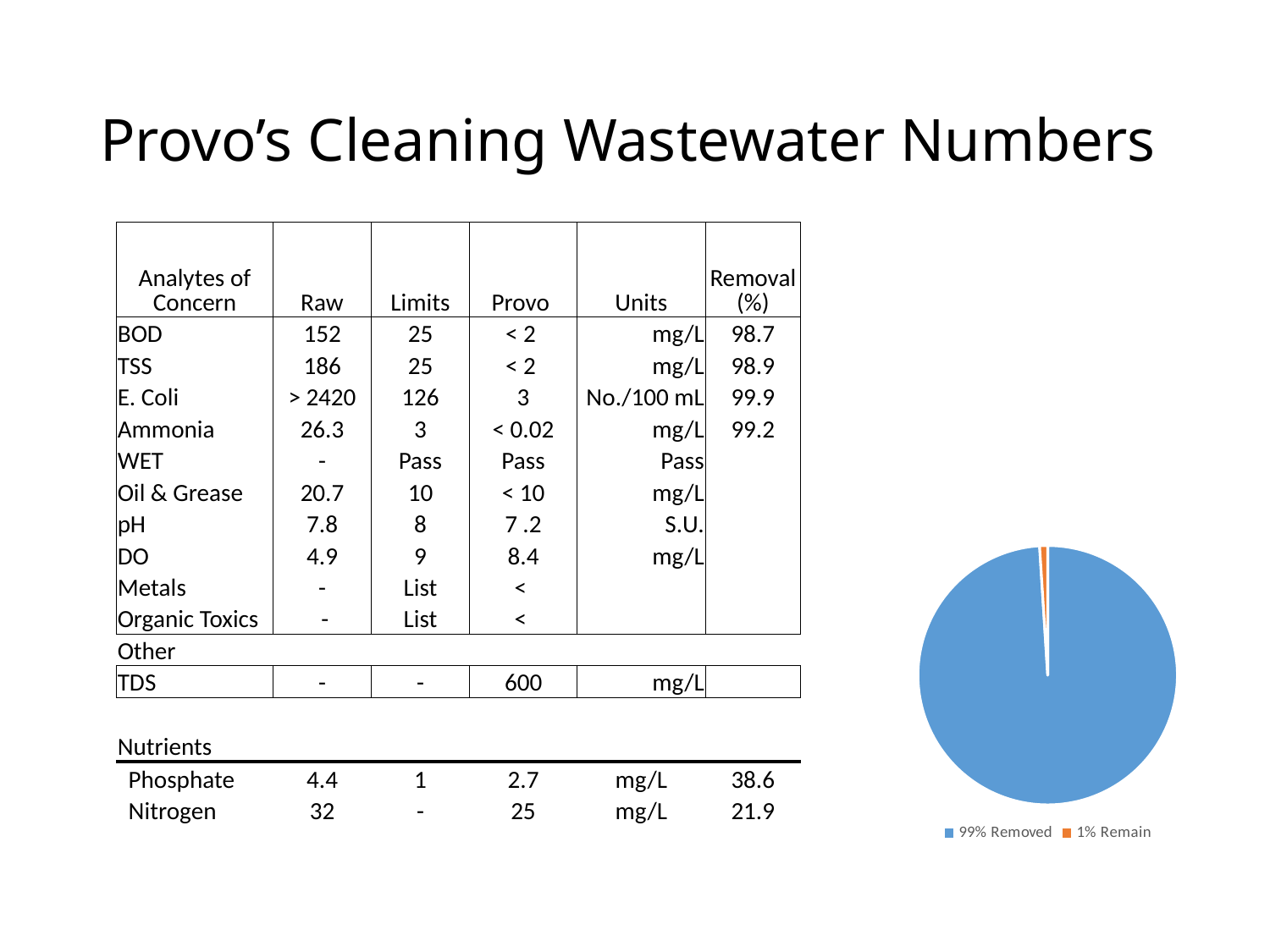
Which slice of the pie chart is the smallest? 1% Remain How many entries does the legend of the pie chart list? 2 Which slice of the pie chart is the largest? 99% Removed According to the legend of the pie chart, what share of the pie does the 'Removed' slice represent? 99% What kind of chart is shown on the right side of the slide? pie chart In the pie chart, which is larger: the '99% Removed' slice or the '1% Remain' slice? 99% Removed According to the legend of the pie chart, what share of the pie does the 'Remain' slice represent? 1% How many slices does the pie chart on the right have? 2 What colour is the '1% Remain' slice in the pie chart? orange What colour is the '99% Removed' slice in the pie chart? blue